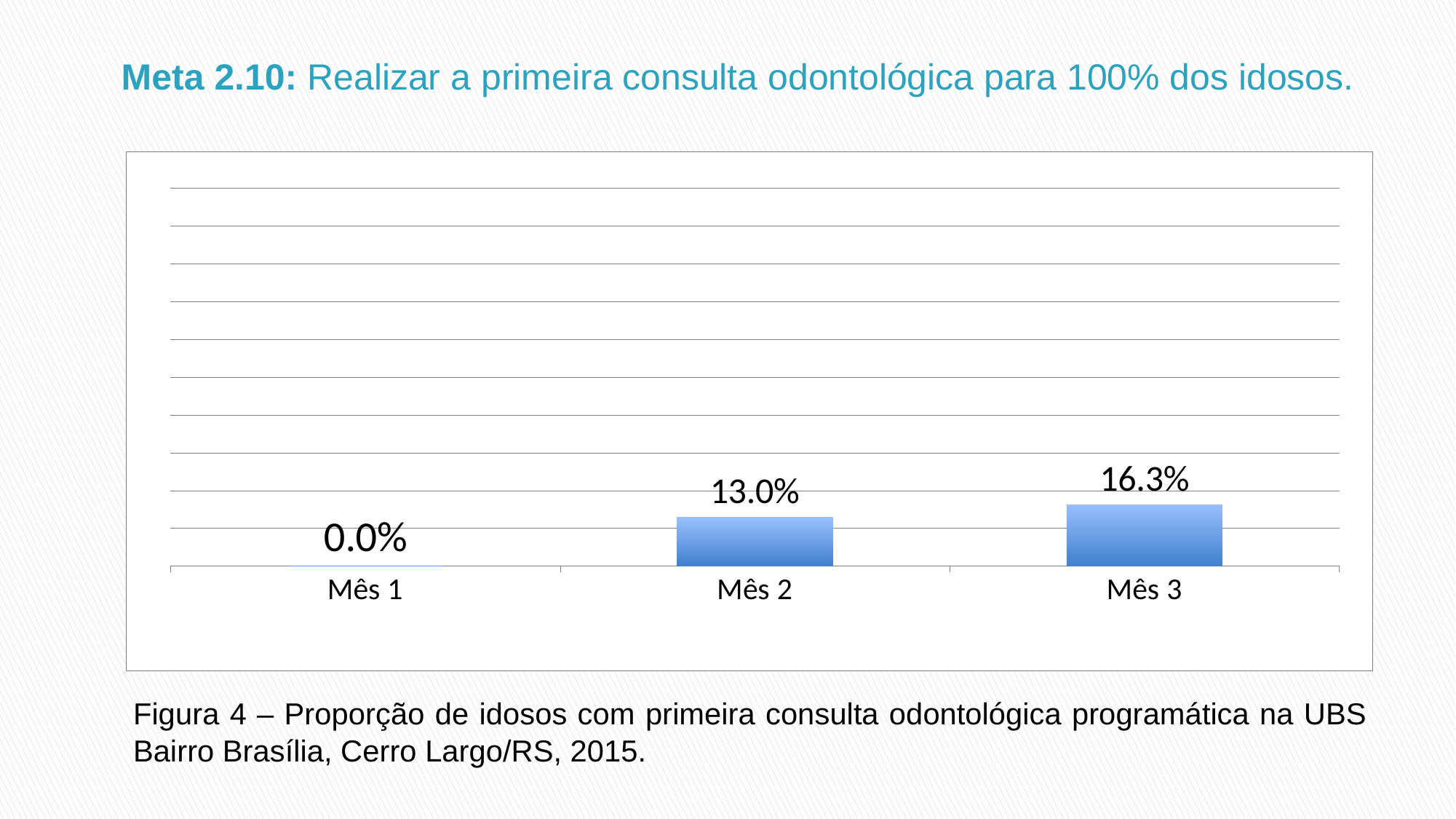
What kind of chart is shown on the slide? Bar chart What is the value for Mês 3? 16.3% What is the difference between the values for Mês 2 and Mês 1? 13.0% Which is larger, the value for Mês 2 or the value for Mês 3? Mês 3 Do the values rise or fall from Mês 1 to Mês 3? Rise What figure number is given in the caption below the chart? Figura 4 Which month has the highest value? Mês 3 What is the difference between the values for Mês 3 and Mês 2? 3.3% How many months are shown on the x axis? 3 Which month has the lowest value? Mês 1 What is the value for Mês 2? 13.0% What is the value for Mês 1? 0.0%